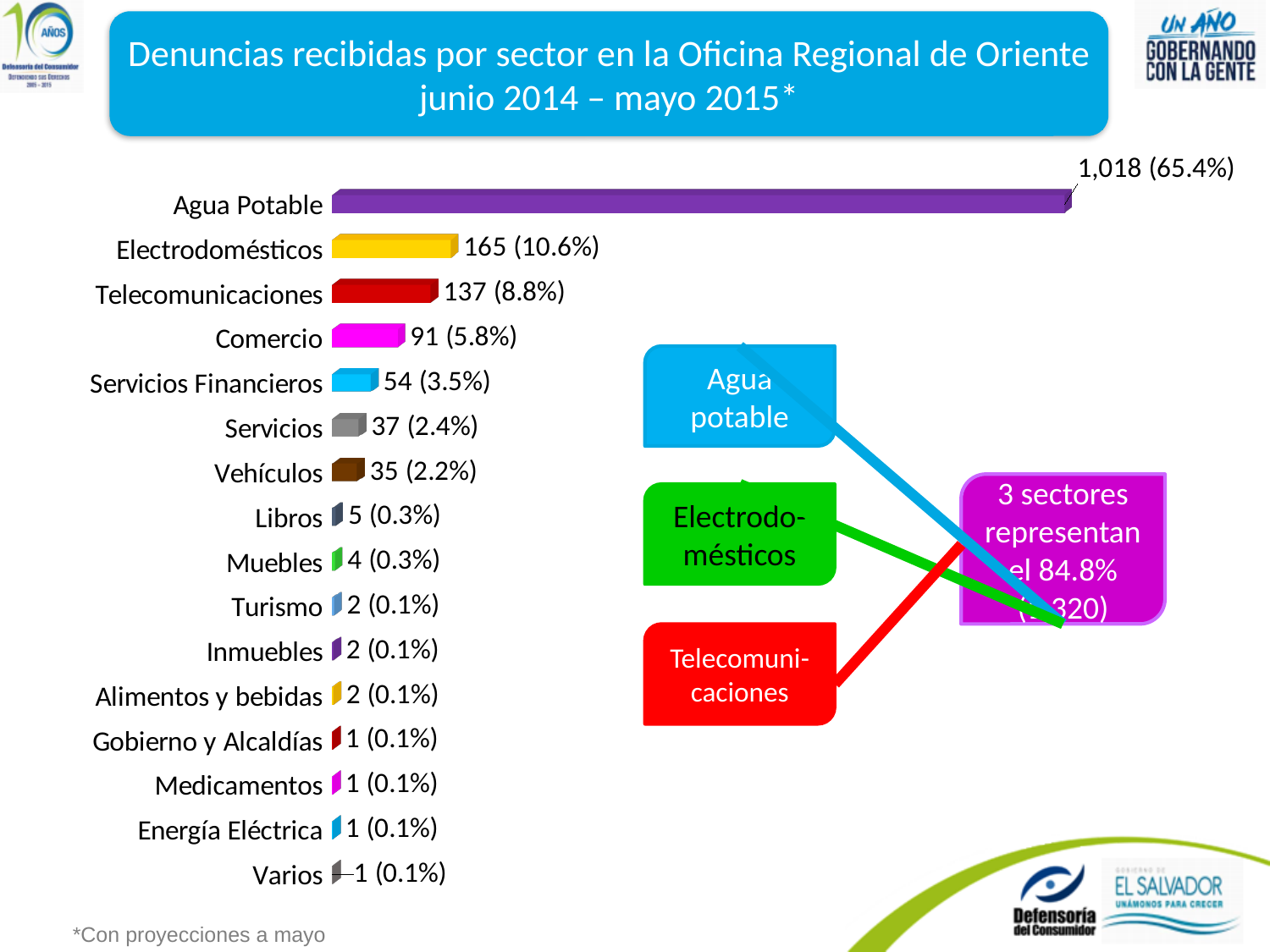
What value is shown for Telecomunicaciones? 137 (8.8%) What is the title of the chart? Denuncias recibidas por sector en la Oficina Regional de Oriente junio 2014 – mayo 2015* What is the difference in complaints between Comercio and Servicios Financieros? 37 How many sectors (categories) are shown in the chart? 16 What percentage is shown for Servicios Financieros? 3.5% What kind of chart is shown on the slide? Bar chart Which sector has more complaints, Servicios or Vehículos? Servicios What value is shown for Electrodomésticos? 165 (10.6%) How many complaints (denuncias) were received for Agua Potable? 1,018 (65.4%) According to the callout box, what share of complaints do the top 3 sectors represent? 84.8% Which sector received the most complaints? Agua Potable What is the difference in complaints between Electrodomésticos and Telecomunicaciones? 28